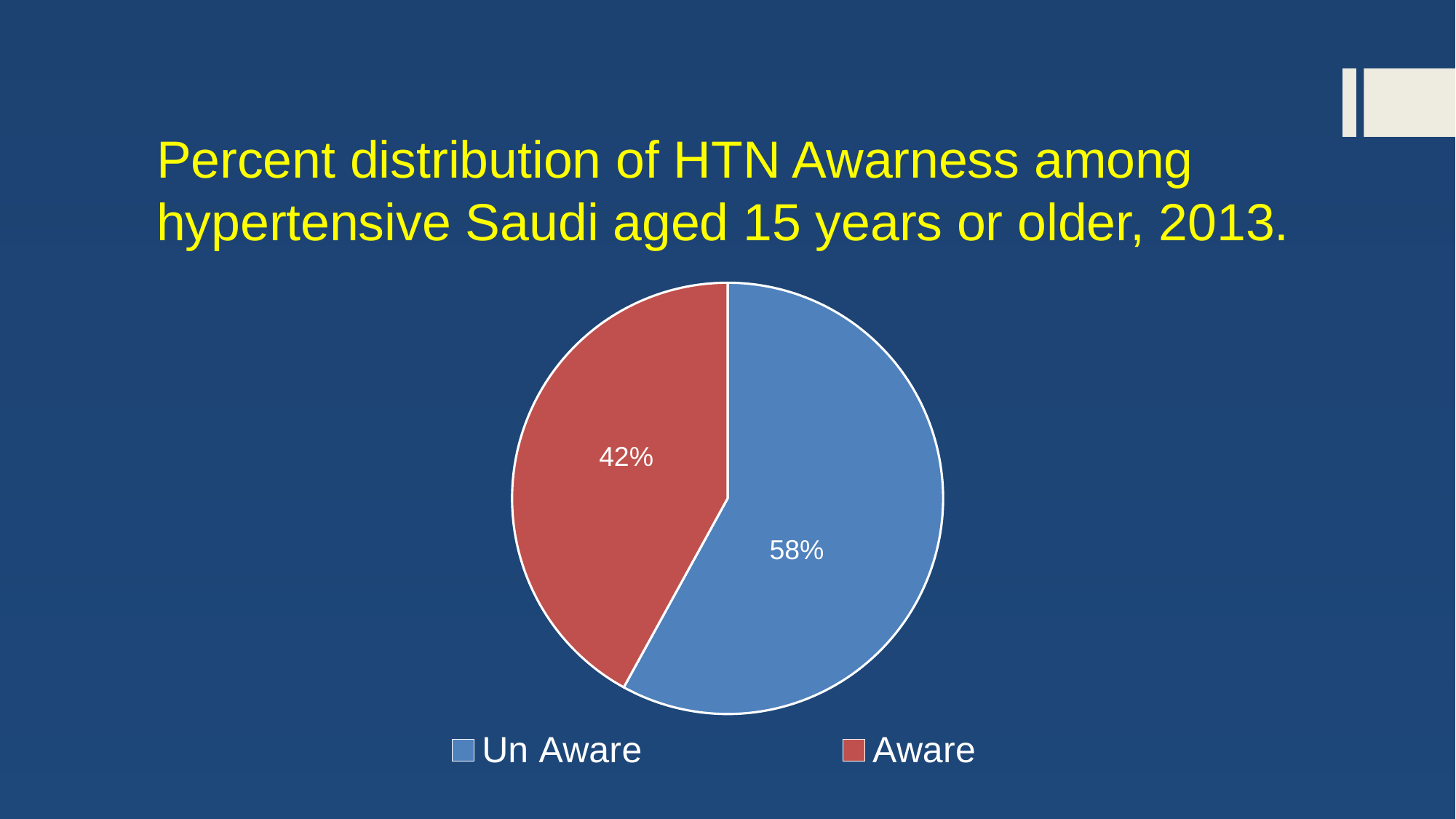
What percentage of the pie is labelled Un Aware? 58% What kind of chart is shown on the slide? Pie chart How many slices does the pie chart have? 2 What is the difference in percentage points between the Un Aware and Aware slices? 16 What share of the pie does the Aware slice represent? 42% How many entries does the legend list? 2 What percentage of the pie is labelled Aware? 42% Which slice is the largest? Un Aware Which is larger, the Aware slice or the Un Aware slice? Un Aware What is the title of the chart on the slide? Percent distribution of HTN Awarness among hypertensive Saudi aged 15 years or older, 2013. Which slice is the smallest? Aware What colour is the Un Aware slice? Blue